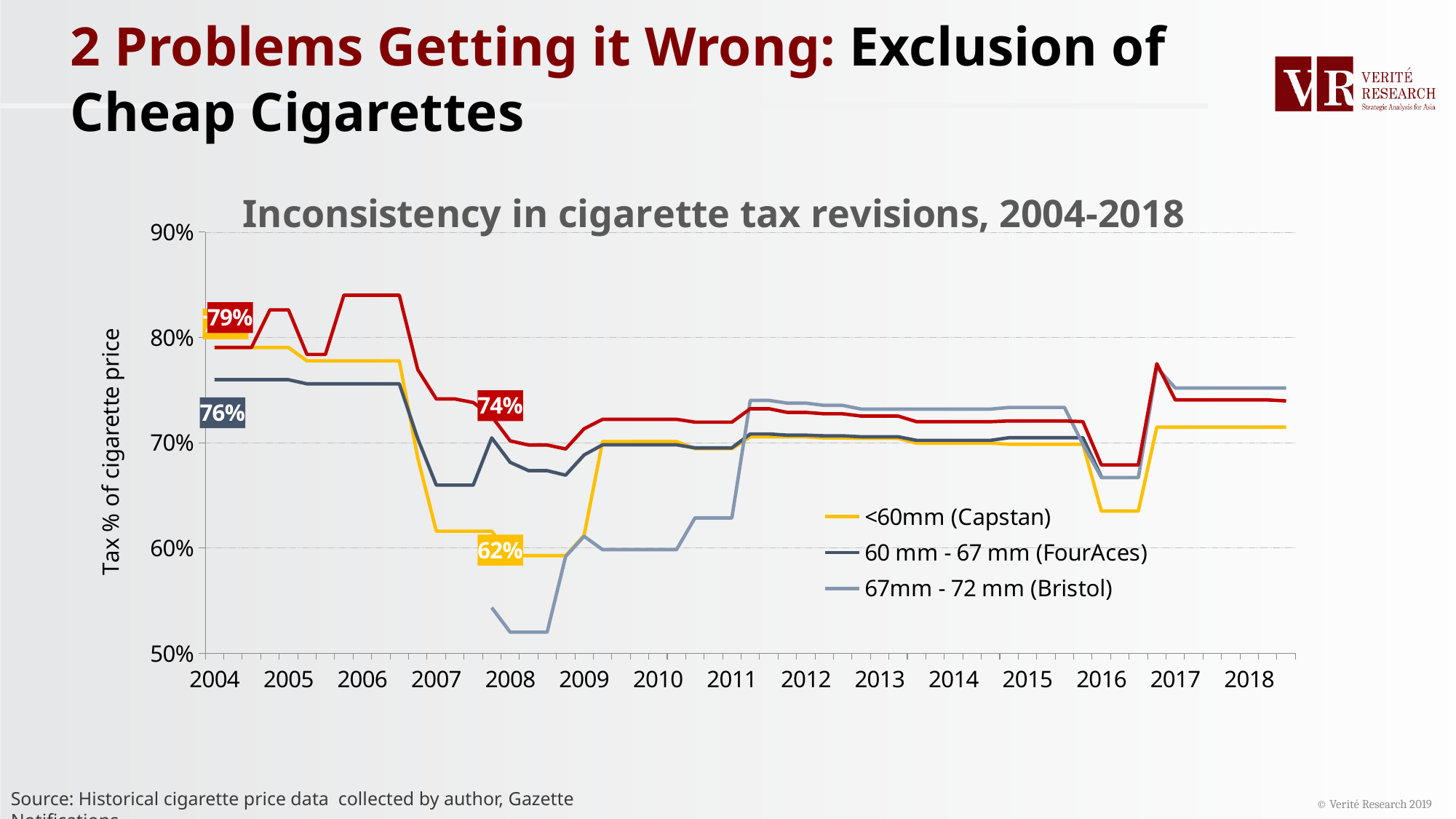
What is the labelled value for the 60 mm - 67 mm (FourAces) series in 2004? 76% How many series does the chart legend list? 3 Is the value for the 67mm - 72 mm (Bristol) series in 2012 greater or less than 70%? greater What is the labelled value for the <60mm (Capstan) series in 2008? 62% What kind of chart is shown on the slide? line chart Is the value for the <60mm (Capstan) series in 2016 greater or less than 70%? less Does the <60mm (Capstan) series rise or fall between 2004 and 2008? fall In 2008, which series has the larger value: <60mm (Capstan) or 67mm - 72 mm (Bristol)? <60mm (Capstan) What is the label on the vertical axis of the chart? Tax % of cigarette price Is the value for the 67mm - 72 mm (Bristol) series in 2008 greater or less than 60%? less Does the 67mm - 72 mm (Bristol) series rise or fall between 2008 and 2012? rise What is the title of the chart? Inconsistency in cigarette tax revisions, 2004-2018